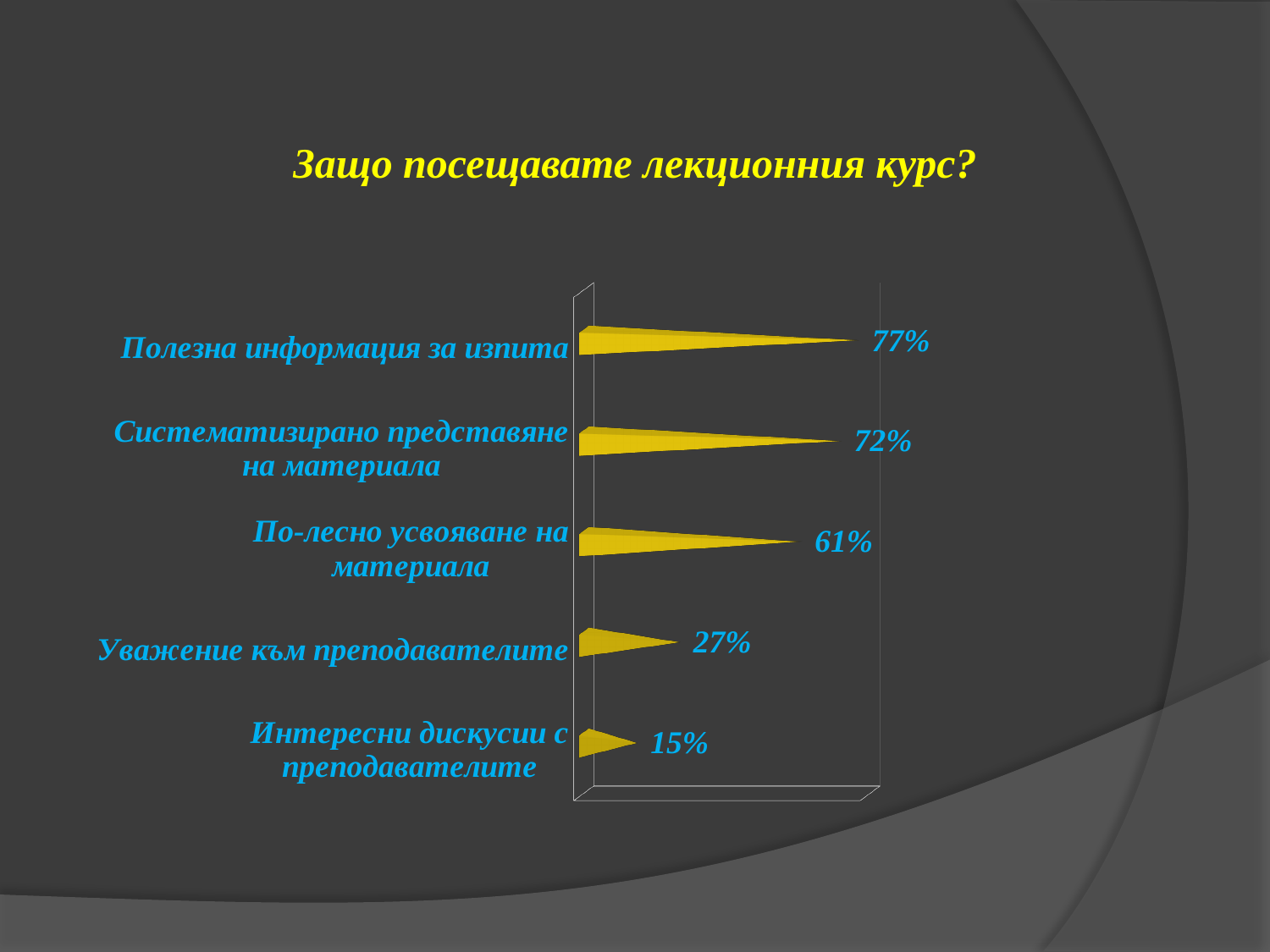
Which category has the lowest value? Интересни дискусии с преподавателите Which is larger: the value for "По-лесно усвояване на материала" or the value for "Уважение към преподавателите"? По-лесно усвояване на материала What kind of chart is shown on the slide? Bar chart What is the value for "Уважение към преподавателите"? 27% What is the value for "По-лесно усвояване на материала"? 61% Which category has the highest value? Полезна информация за изпита What is the value for "Полезна информация за изпита"? 77% How many categories are shown in the chart? 5 What is the title of the slide? Защо посещавате лекционния курс? What is the value for "Интересни дискусии с преподавателите"? 15% What is the difference between the values for "Полезна информация за изпита" and "Интересни дискусии с преподавателите"? 62% What is the value for "Систематизирано представяне на материала"? 72%